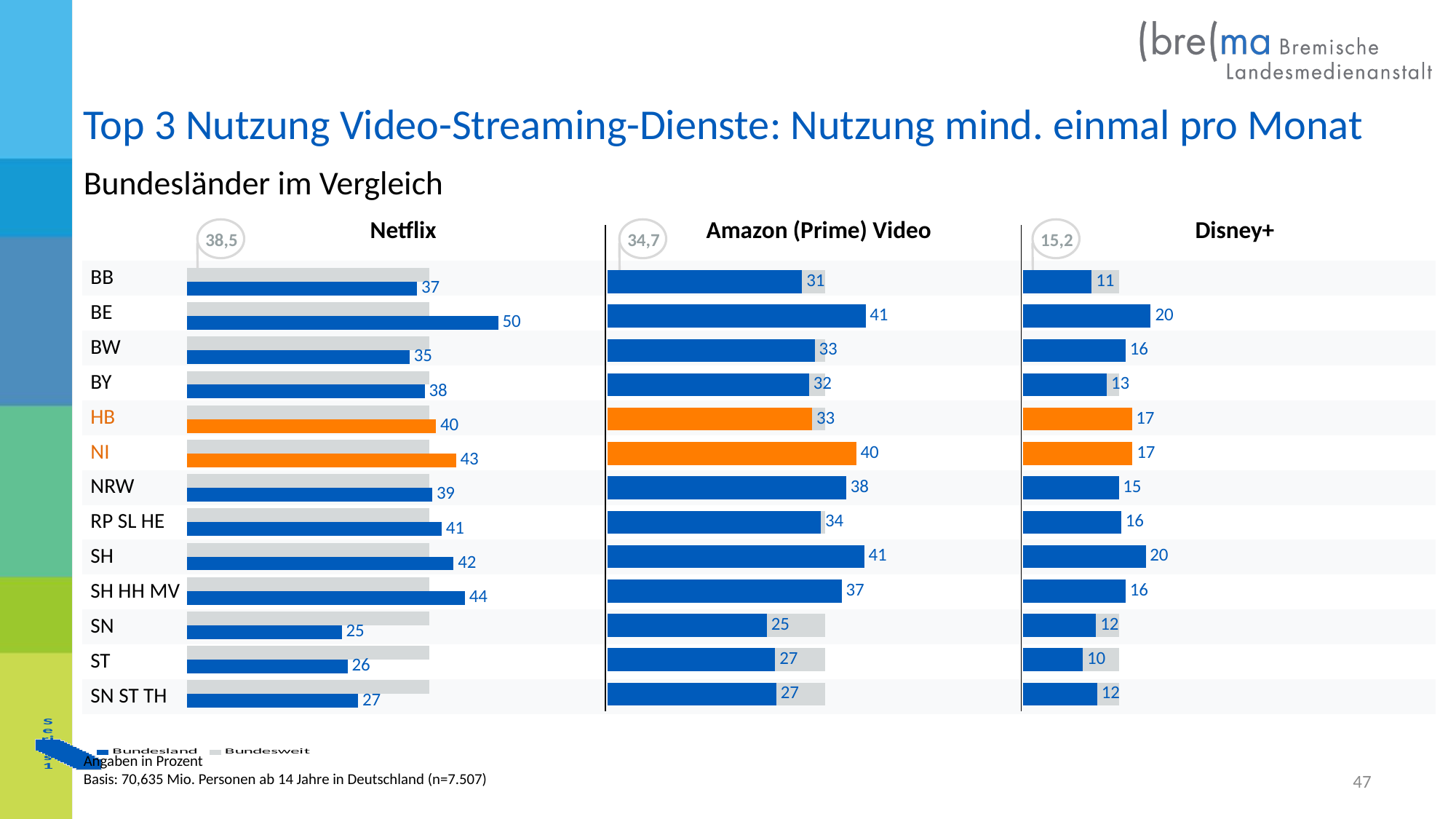
In the Disney+ chart, what is the value for HB? 17 In the Disney+ chart, which Bundesland has the lowest value? ST What kind of chart is the Amazon (Prime) Video chart? Bar chart How many Bundesland categories are shown in the Netflix chart? 13 In the Netflix chart, which is larger, the value for HB or the value for NI? NI In the Netflix chart, which Bundesland has the highest value? BE In the Amazon (Prime) Video chart, what is the difference between the values for BE and SN? 16 In the Amazon (Prime) Video chart, what is the value for NI? 40 In the Netflix chart, what is the value for BE? 50 In the Disney+ chart, which is larger, the value for BE or the value for BY? BE What is the Bundesweit (nationwide) value shown for Disney+? 15,2 In the Netflix chart, which Bundesland has the lowest value? SN